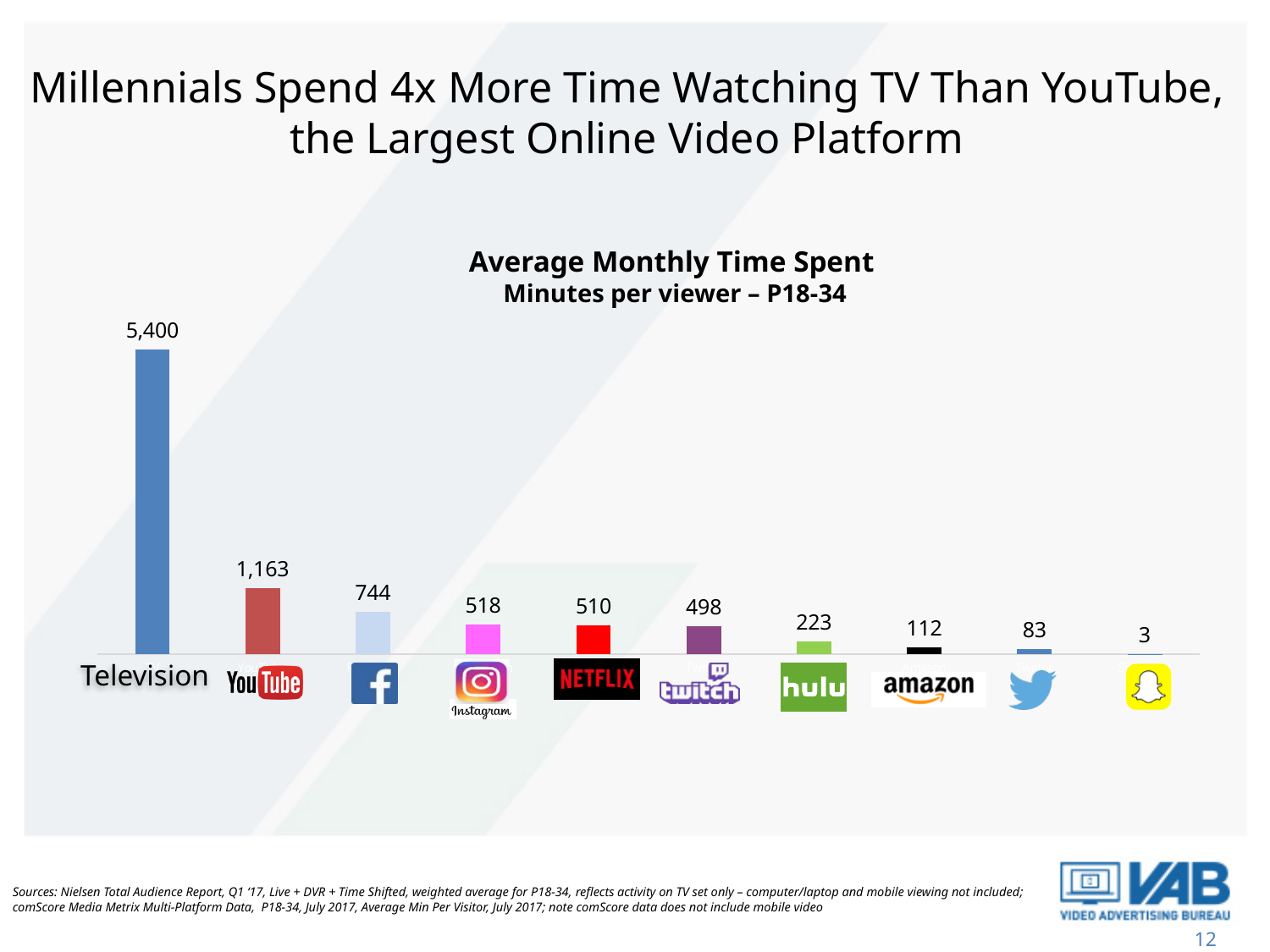
What is the average monthly time spent for YouTube? 1,163 Which has a larger value, Amazon or Twitter? Amazon What is the difference between the Television value and the YouTube value? 4,237 What is the title of the chart? Average Monthly Time Spent Which platform has the highest average monthly time spent? Television What is the average monthly time spent for Television? 5,400 What is the difference between the Facebook value and the Instagram value? 226 Which platform has the lowest average monthly time spent? Snapchat What is the value shown for Hulu? 223 How many platforms are shown in the chart? 10 What is the value shown for Netflix? 510 What kind of chart is shown on the slide? Bar chart